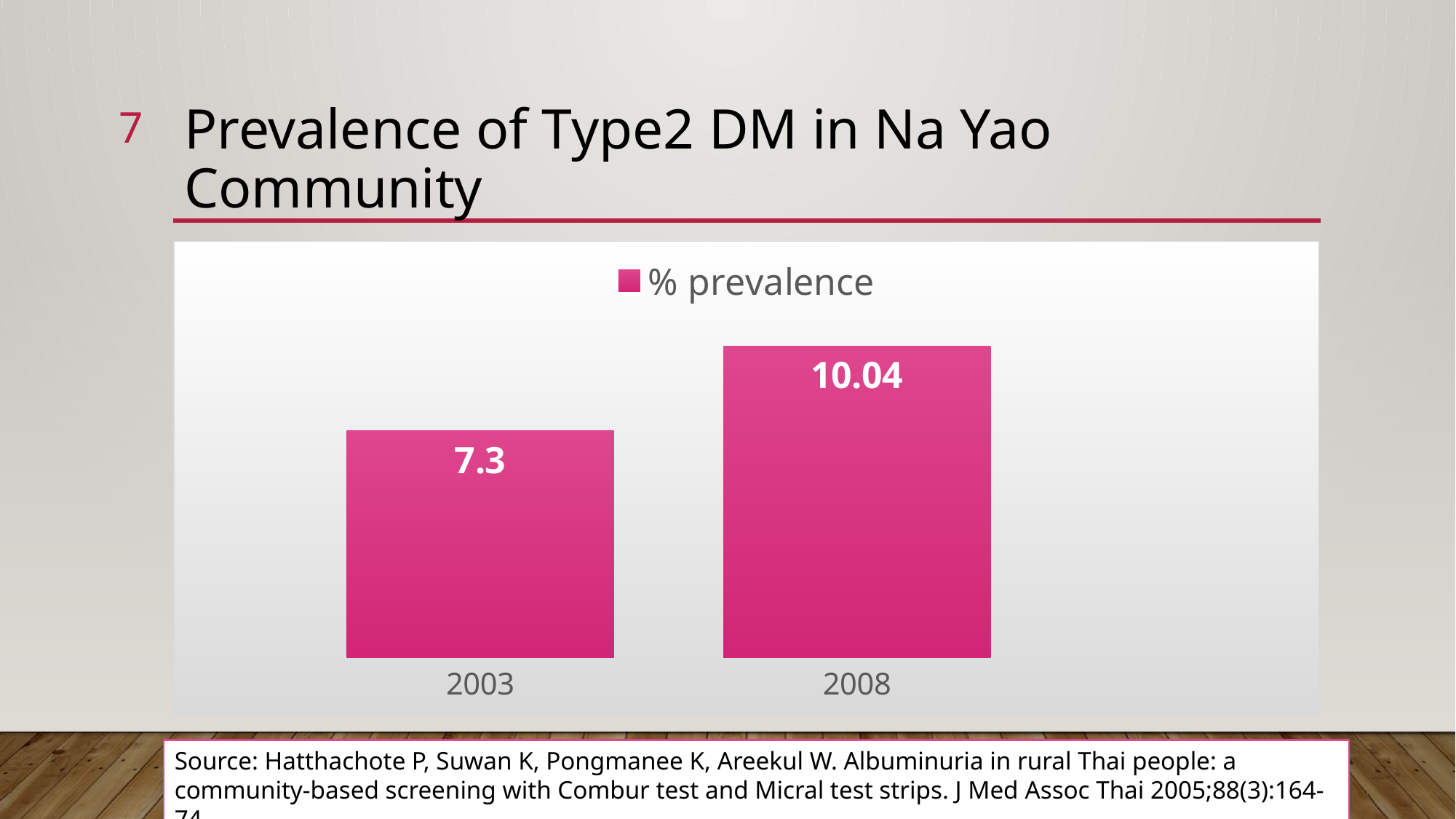
What is the name of the series shown in the legend? % prevalence What is the title of the slide containing the chart? Prevalence of Type2 DM in Na Yao Community What is the % prevalence value for 2003? 7.3 Does the % prevalence rise or fall from 2003 to 2008? Rise How many series does the legend list? 1 What is the % prevalence value for 2008? 10.04 What is the difference in % prevalence between 2008 and 2003? 2.74 How many years (categories) are shown in the chart? 2 What kind of chart is shown on the slide? Bar chart Which year has a larger % prevalence, 2003 or 2008? 2008 Which year has the lowest % prevalence? 2003 Which year has the highest % prevalence? 2008